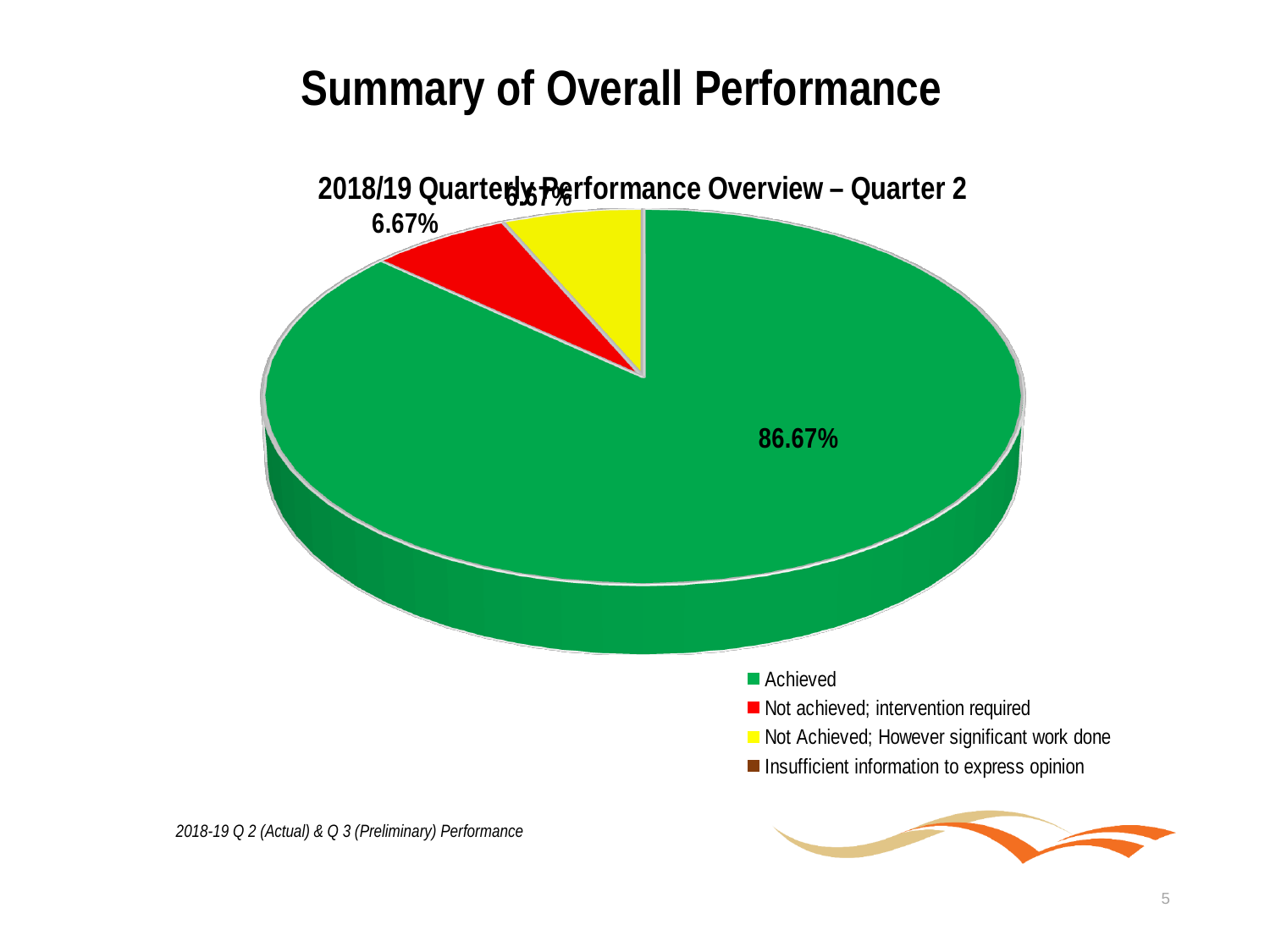
What is the difference between the Achieved share and the Not achieved; intervention required share? 80.00% What type of chart is shown on the slide? Pie chart What is the title of the chart? 2018/19 Quarterly Performance Overview – Quarter 2 Which is larger: the Achieved slice or the Not Achieved; However significant work done slice? Achieved What percentage is shown for the red slice, Not achieved; intervention required? 6.67% What percentage of the pie is labelled for the Achieved category? 86.67% What percentage is shown for the yellow slice, Not Achieved; However significant work done? 6.67% What colour represents the Achieved category in the chart? Green Which category has the largest share of the pie? Achieved What is the combined share of the two Not Achieved categories? 13.34% How many categories does the legend list? 4 Is the share for Achieved greater or less than 50%? greater